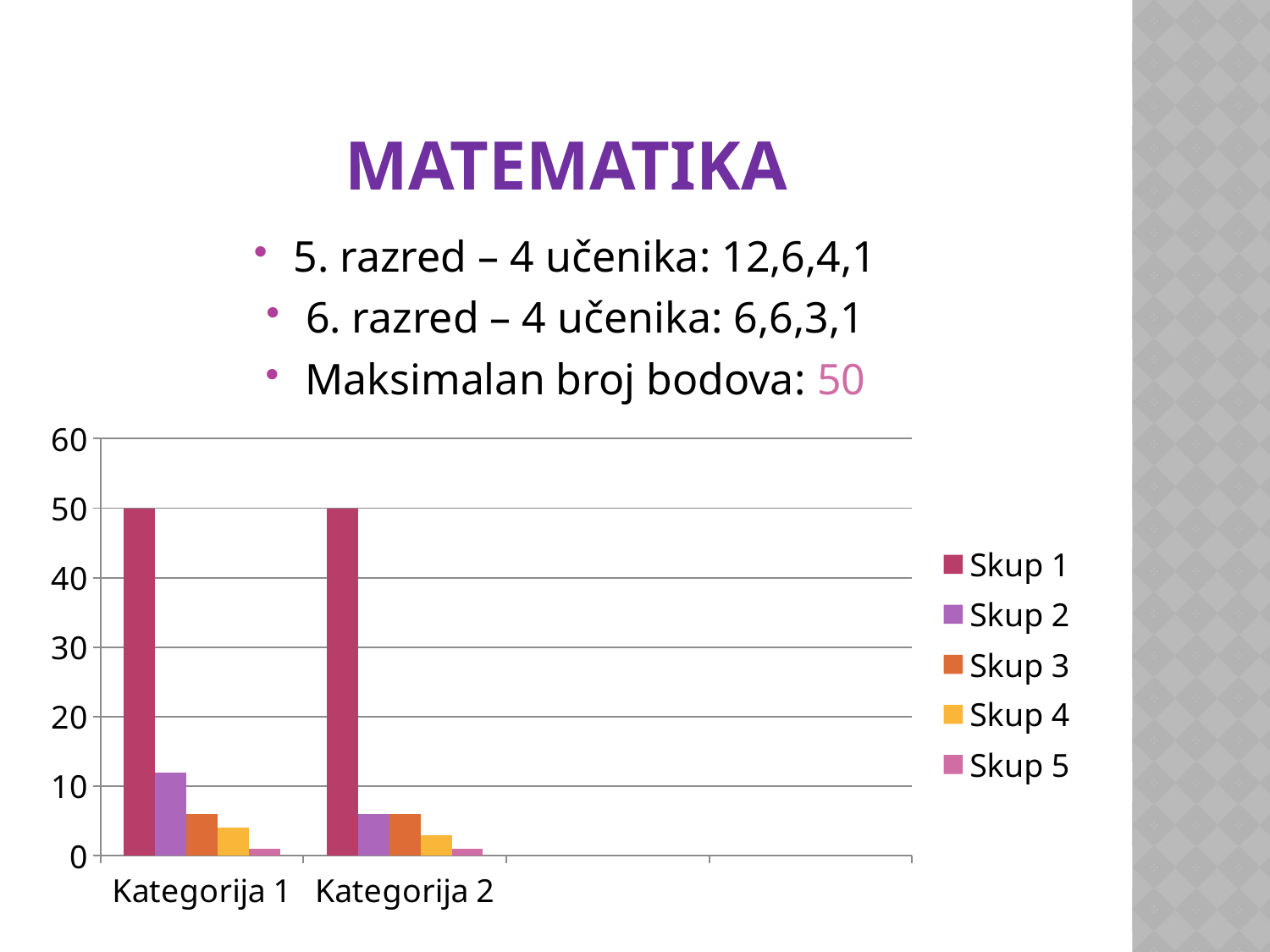
What is the name of the last series listed in the chart legend? Skup 5 Which is larger: Skup 2 in Kategorija 1 or Skup 2 in Kategorija 2? Skup 2 in Kategorija 1 What is the value of Skup 1 for Kategorija 2? 50 Which series has the lowest value in Kategorija 2? Skup 5 Which series has the highest value in Kategorija 1? Skup 1 Is the value for Skup 4 in Kategorija 2 greater or less than 10? less What kind of chart is shown on the slide? bar chart How many categories are shown on the x axis of the chart? 2 What is the value of Skup 1 for Kategorija 1? 50 Is the value for Skup 2 in Kategorija 2 greater or less than 10? less Is the value for Skup 2 in Kategorija 1 greater or less than 10? greater How many series does the chart legend list? 5